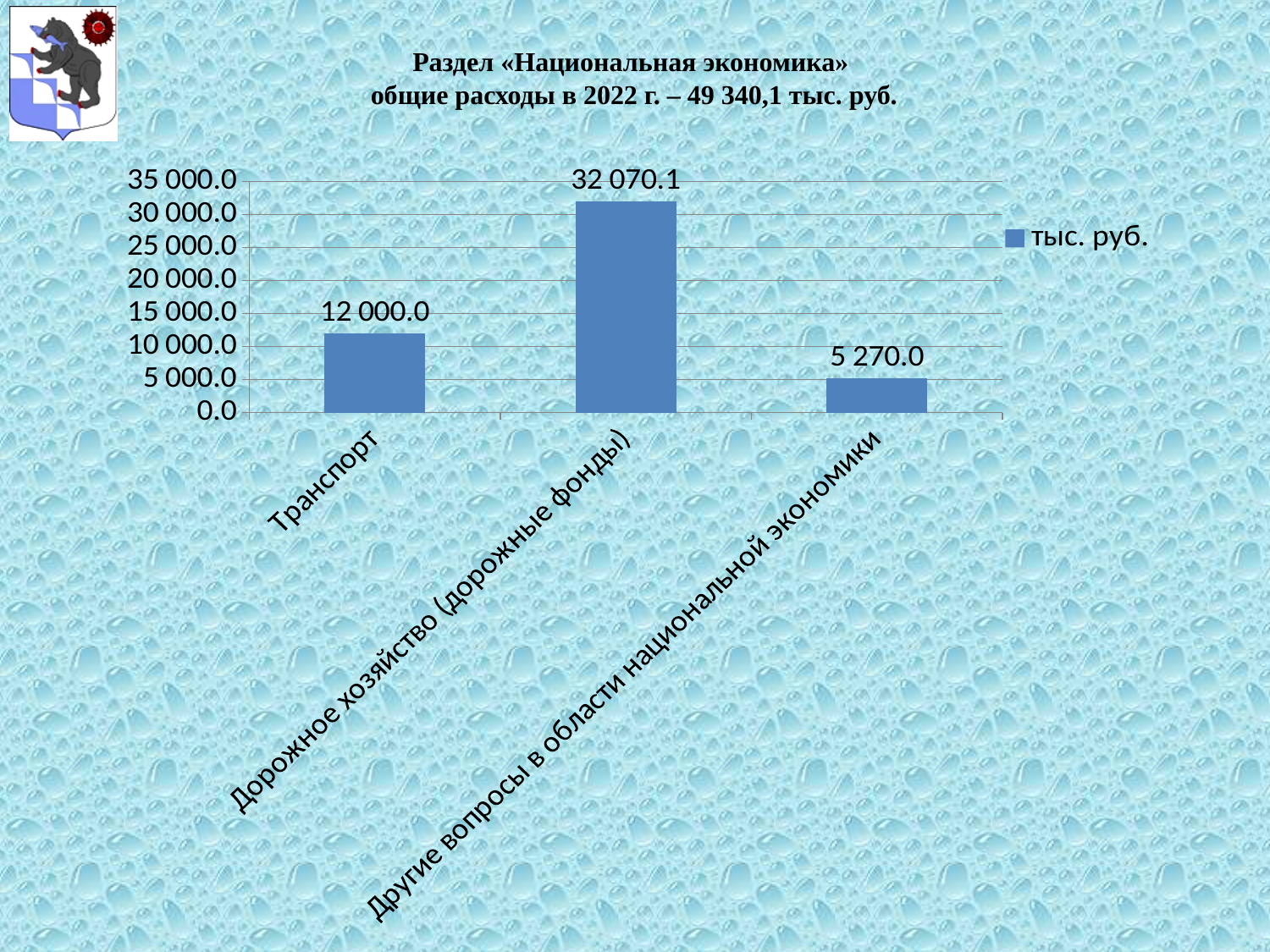
What is the value for Другие вопросы в области национальной экономики? 5 270.0 Which category has the highest value? Дорожное хозяйство (дорожные фонды) What is the difference between the values for Транспорт and Другие вопросы в области национальной экономики? 6 730.0 What kind of chart is shown on the slide? bar chart What is the value for Транспорт? 12 000.0 Which is larger: the value for Транспорт or the value for Другие вопросы в области национальной экономики? Транспорт What is the difference between the values for Дорожное хозяйство (дорожные фонды) and Транспорт? 20 070.1 Which category has the lowest value? Другие вопросы в области национальной экономики What series name does the legend show? тыс. руб. Is the value for Дорожное хозяйство (дорожные фонды) greater or less than 30 000.0? greater How many categories are shown on the chart? 3 What is the value for Дорожное хозяйство (дорожные фонды)? 32 070.1